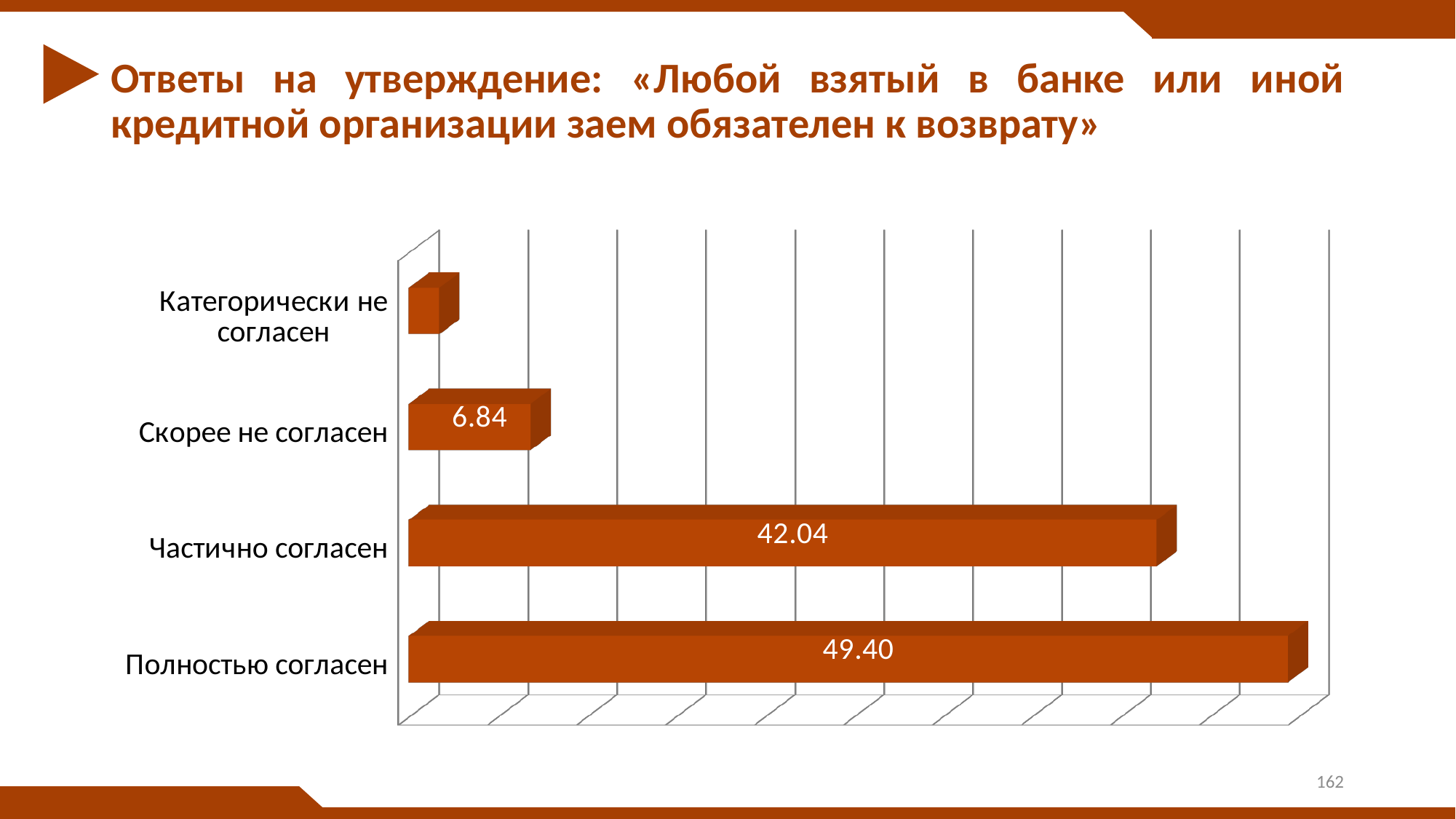
What value is shown for «Скорее не согласен»? 6.84 Which is larger: the value for «Частично согласен» or for «Полностью согласен»? Полностью согласен What value is shown for «Полностью согласен»? 49.40 Which category has the lowest value? Категорически не согласен Which is larger: the value for «Скорее не согласен» or for «Категорически не согласен»? Скорее не согласен What is the difference between the values for «Полностью согласен» and «Частично согласен»? 7.36 What colour are the bars in the chart? Orange-brown Which category has the highest value? Полностью согласен What value is shown for «Частично согласен»? 42.04 What kind of chart is shown on the slide? Bar chart How many categories are shown in the chart? 4 What is the difference between the values for «Частично согласен» and «Скорее не согласен»? 35.20